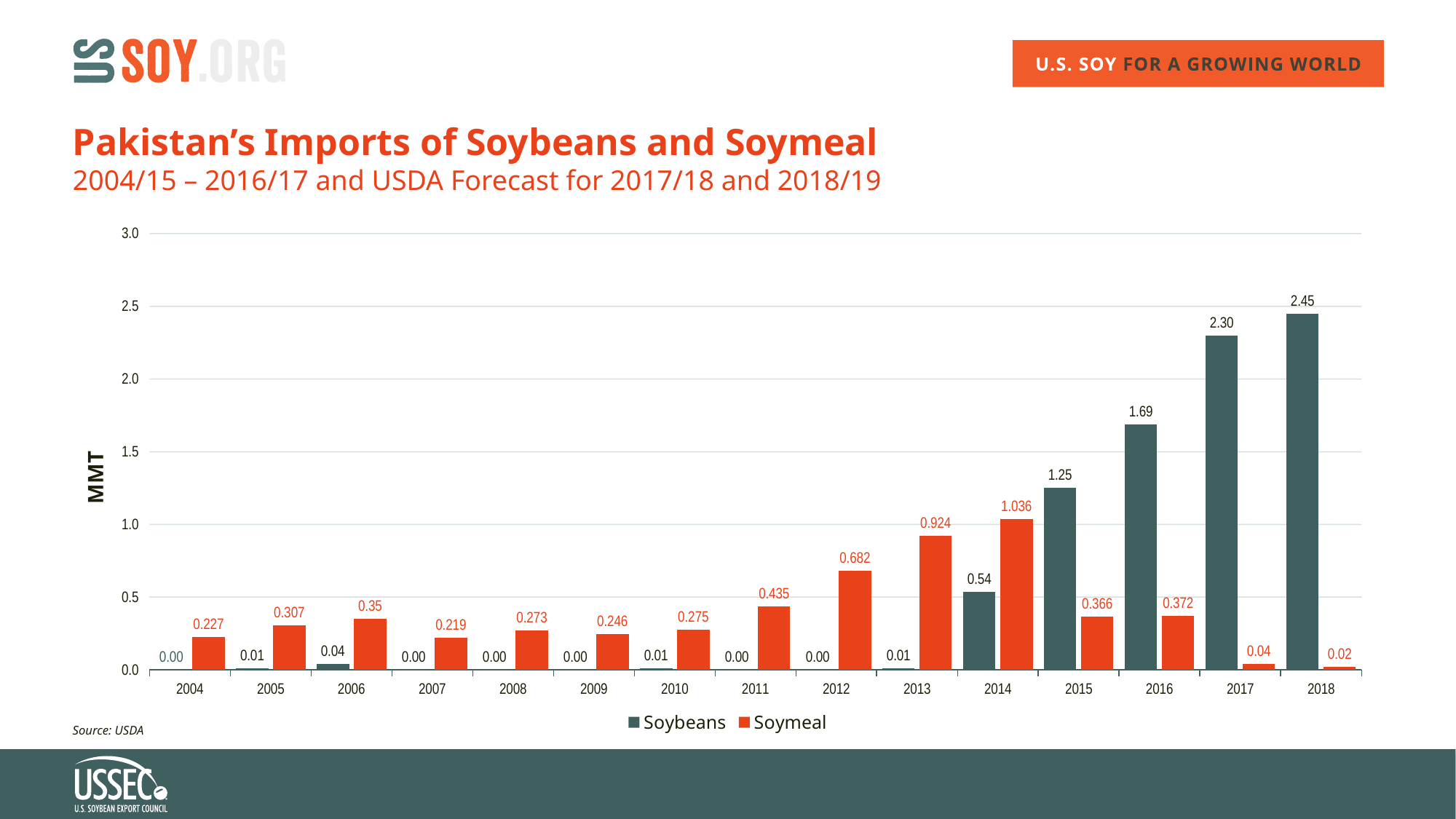
What is the Soymeal import value for 2006? 0.35 What is the Soymeal import value for 2014? 1.036 What is the Soybeans import value for 2018? 2.45 What kind of chart is shown on the slide? Bar chart How many years are shown on the x axis? 15 What is the label on the y axis? MMT What is the Soybeans import value for 2015? 1.25 How many series does the legend list? 2 Which year has the highest Soymeal import value? 2014 Which is larger in 2014, the Soybeans value or the Soymeal value? Soymeal What is the difference between the Soybeans values for 2018 and 2017? 0.15 Which year has the highest Soybeans import value? 2018